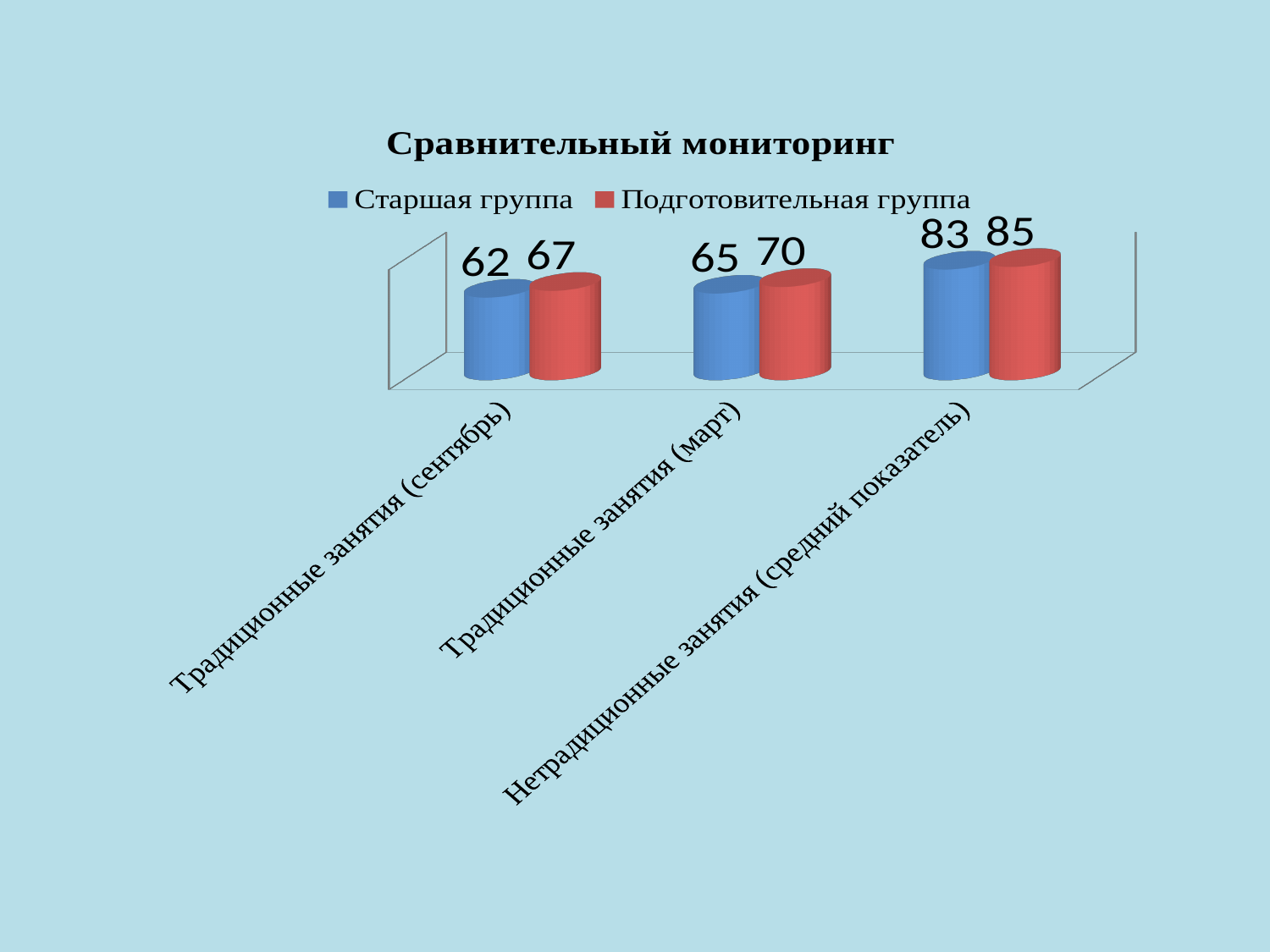
Which category has the lowest value for Подготовительная группа? Традиционные занятия (сентябрь) What kind of chart is shown? Bar chart Which category has the highest value for Старшая группа? Нетрадиционные занятия (средний показатель) What is the difference between Подготовительная группа and Старшая группа in Традиционные занятия (март)? 5 What is the value for Подготовительная группа in Традиционные занятия (март)? 70 What is the difference between the Старшая группа values for Нетрадиционные занятия (средний показатель) and Традиционные занятия (сентябрь)? 21 What is the value for Подготовительная группа in Нетрадиционные занятия (средний показатель)? 85 What is the value for Старшая группа in Традиционные занятия (сентябрь)? 62 What is the title of the chart? Сравнительный мониторинг How many categories are shown on the x axis? 3 How many series does the legend list? 2 Which is larger in Традиционные занятия (сентябрь): Старшая группа or Подготовительная группа? Подготовительная группа